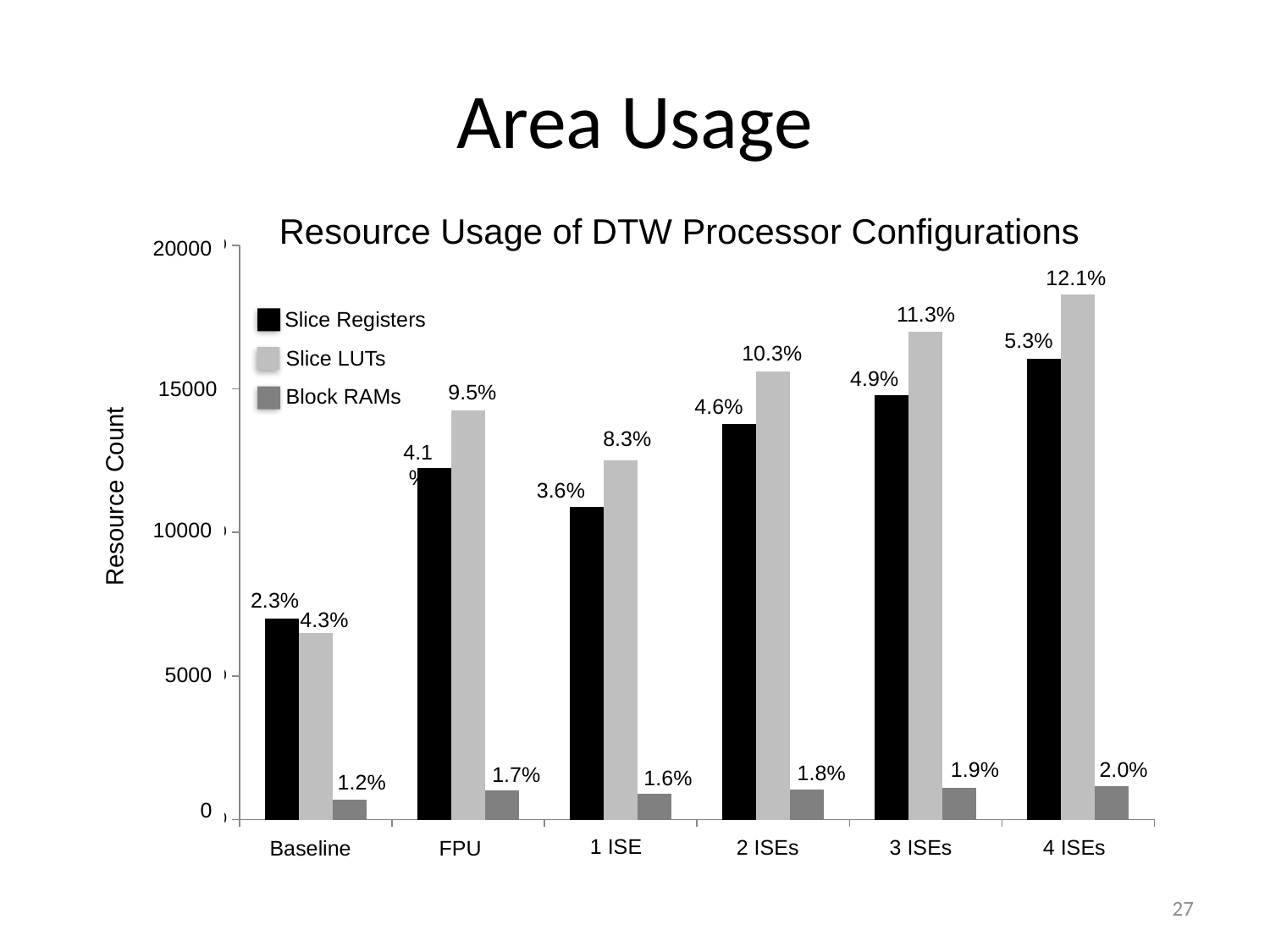
Is the Slice Registers value for Baseline greater or less than 10000? less Is the Slice Registers value for 4 ISEs greater or less than 15000? greater For 2 ISEs, which is larger: Slice Registers or Slice LUTs? Slice LUTs What kind of chart is shown on the slide? bar chart Which configuration has the tallest Slice LUTs bar? 4 ISEs What is the title of the chart? Resource Usage of DTW Processor Configurations How many processor configurations are shown along the x axis? 6 Which configuration has the shortest Slice Registers bar? Baseline How many series does the legend list? 3 What percentage label is shown above the Block RAMs bar for Baseline? 1.2% What percentage label is shown above the Slice LUTs bar for 4 ISEs? 12.1% What percentage label is shown above the Slice Registers bar for 3 ISEs? 4.9%